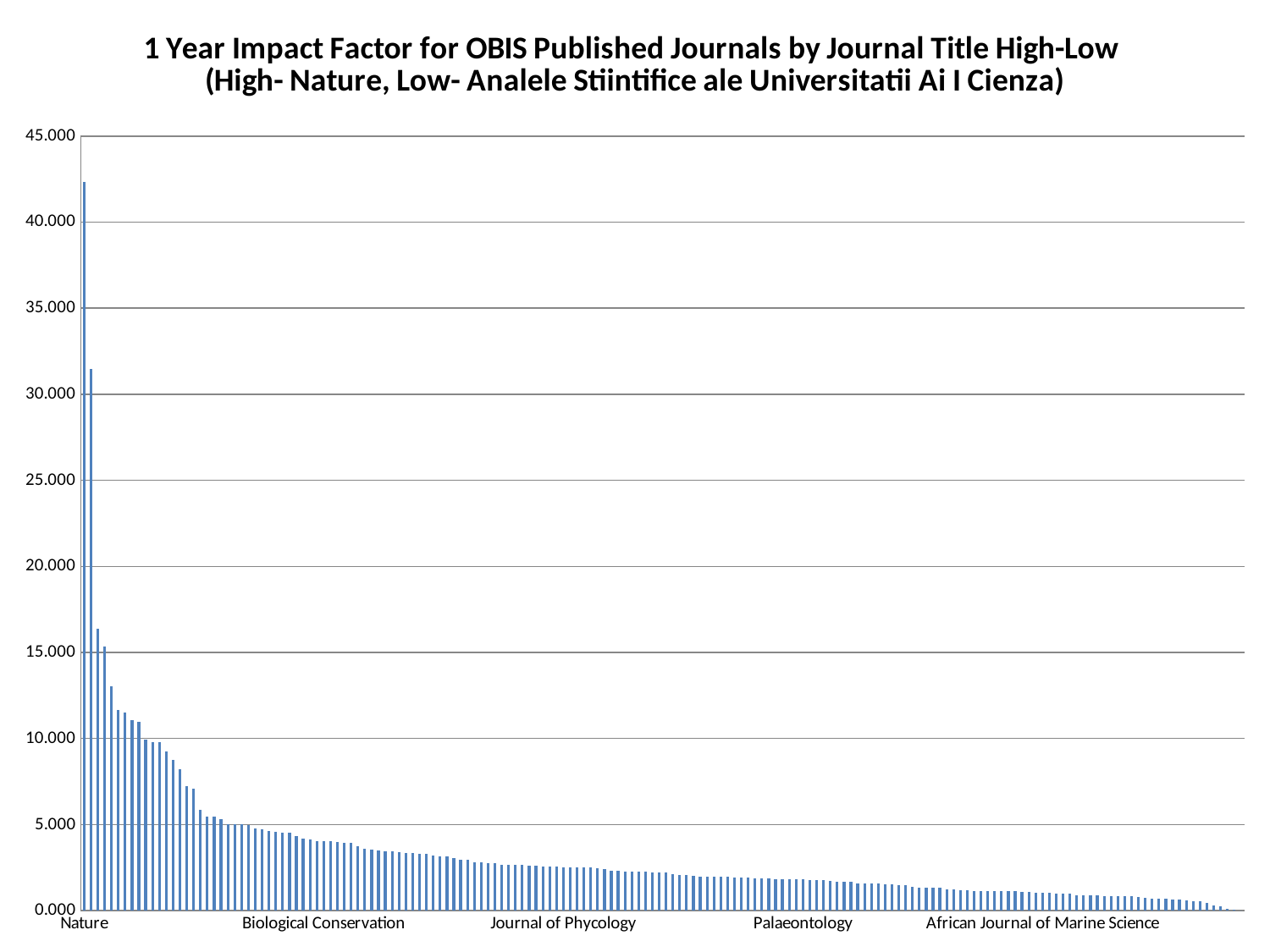
Is the value for African Journal of Marine Science greater or less than 5.000? less Is the value for Biological Conservation greater or less than 10.000? less Which has the larger impact factor, Nature or Biological Conservation? Nature What kind of chart is shown on the slide? bar chart Is the value for Journal of Phycology greater or less than 5.000? less Which journal has the lowest 1 year impact factor in the chart? Analele Stiintifice ale Universitatii Ai I Cienza What is the highest value shown on the y axis? 45.000 Which has the larger impact factor, Journal of Phycology or African Journal of Marine Science? Journal of Phycology Do the values rise or fall moving from left to right along the x axis? fall Which journal has the highest 1 year impact factor in the chart? Nature